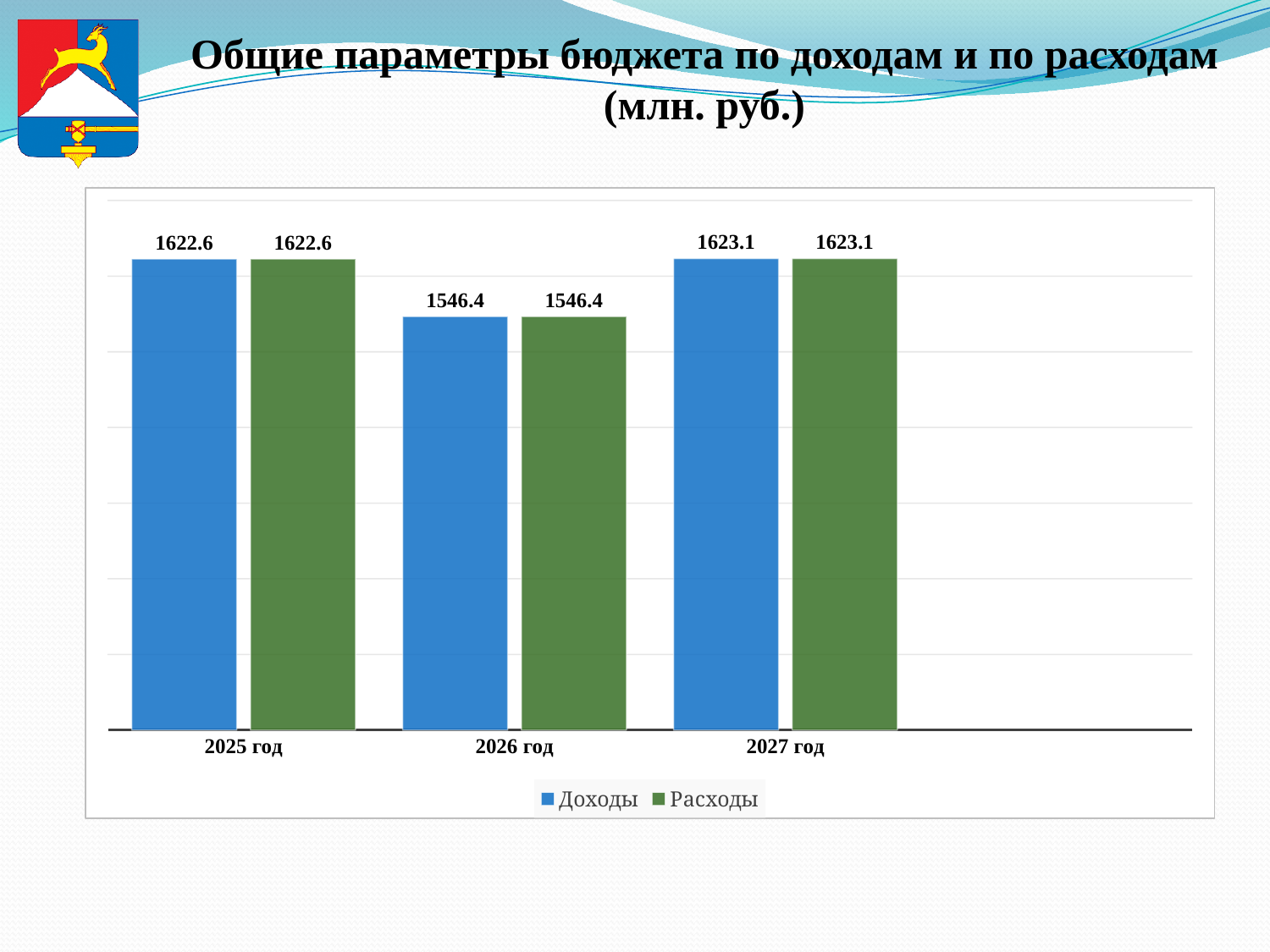
What is the difference between Расходы in 2027 год and Расходы in 2026 год? 76.7 Do the values of Доходы rise or fall from 2025 год to 2026 год? Fall What is the value of Расходы for 2026 год? 1546.4 Which is larger: Доходы in 2025 год or Доходы in 2026 год? Доходы in 2025 год What is the value of Доходы for 2025 год? 1622.6 Which year has the lowest value of Расходы? 2026 год How many series does the legend list? 2 Which year has the highest value of Доходы? 2027 год What is the value of Доходы for 2027 год? 1623.1 How many years are shown on the x axis? 3 What is the difference between Доходы in 2025 год and Доходы in 2026 год? 76.2 What kind of chart is shown on the slide? Bar chart